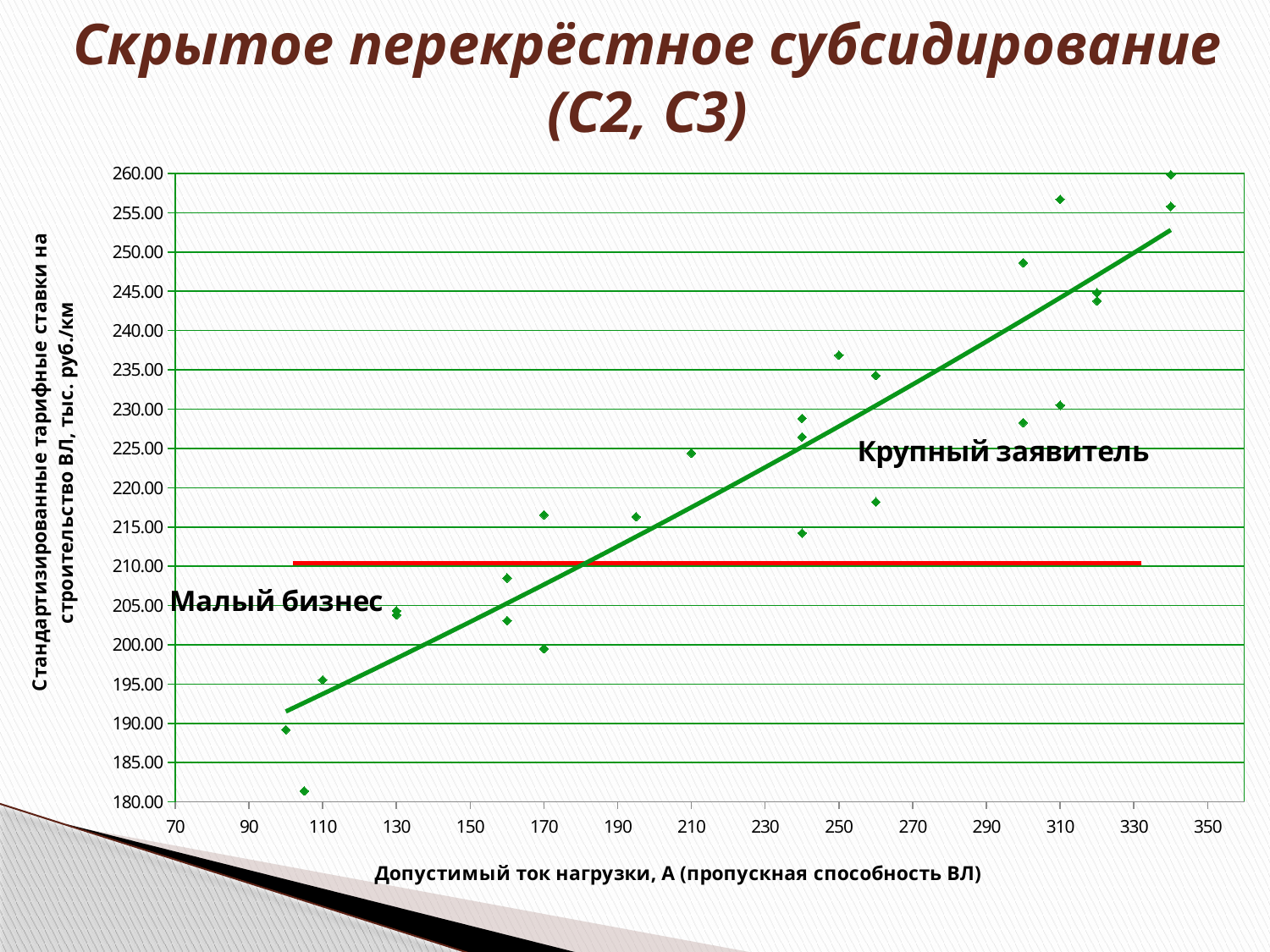
Is the highest plotted point on the chart greater or less than 255.00? greater Is the plotted point at x = 100 greater or less than 190.00? less What kind of chart is shown on the slide? Scatter chart What label is placed on the chart near the upper-right group of points? Крупный заявитель What is the title of the x axis? Допустимый ток нагрузки, А (пропускная способность ВЛ) At x = 300, which line is higher: the green trend line or the red horizontal line? The green trend line Is the horizontal red line greater or less than 215.00 on the y axis? less Which is larger: the plotted value at x = 250 or the plotted value at x = 110? The value at x = 250 Do the plotted values generally rise or fall as the allowable load current increases along the x axis? Rise